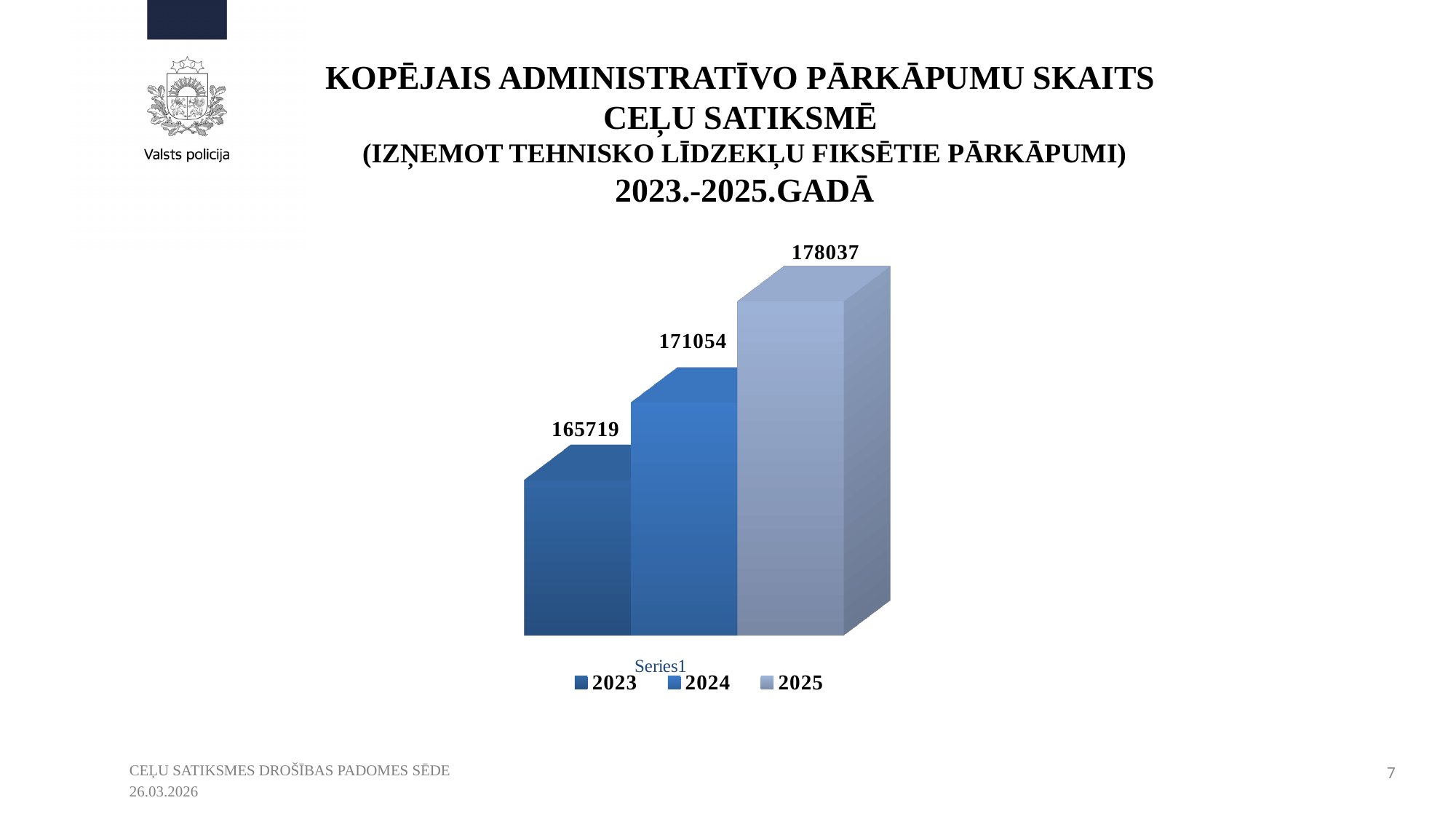
What is the value shown for 2024? 171054 What is the difference between the values for 2025 and 2023? 12318 Which year has the highest value? 2025 What is the difference between the values for 2024 and 2023? 5335 What is the value shown for 2025? 178037 Which year has the lowest value? 2023 Do the values rise or fall from 2023 to 2025? rise What is the difference between the values for 2025 and 2024? 6983 How many bars are plotted in the chart? 3 What kind of chart is shown on the slide? bar chart Which is larger, the value for 2023 or the value for 2025? 2025 What is the value shown for 2023? 165719